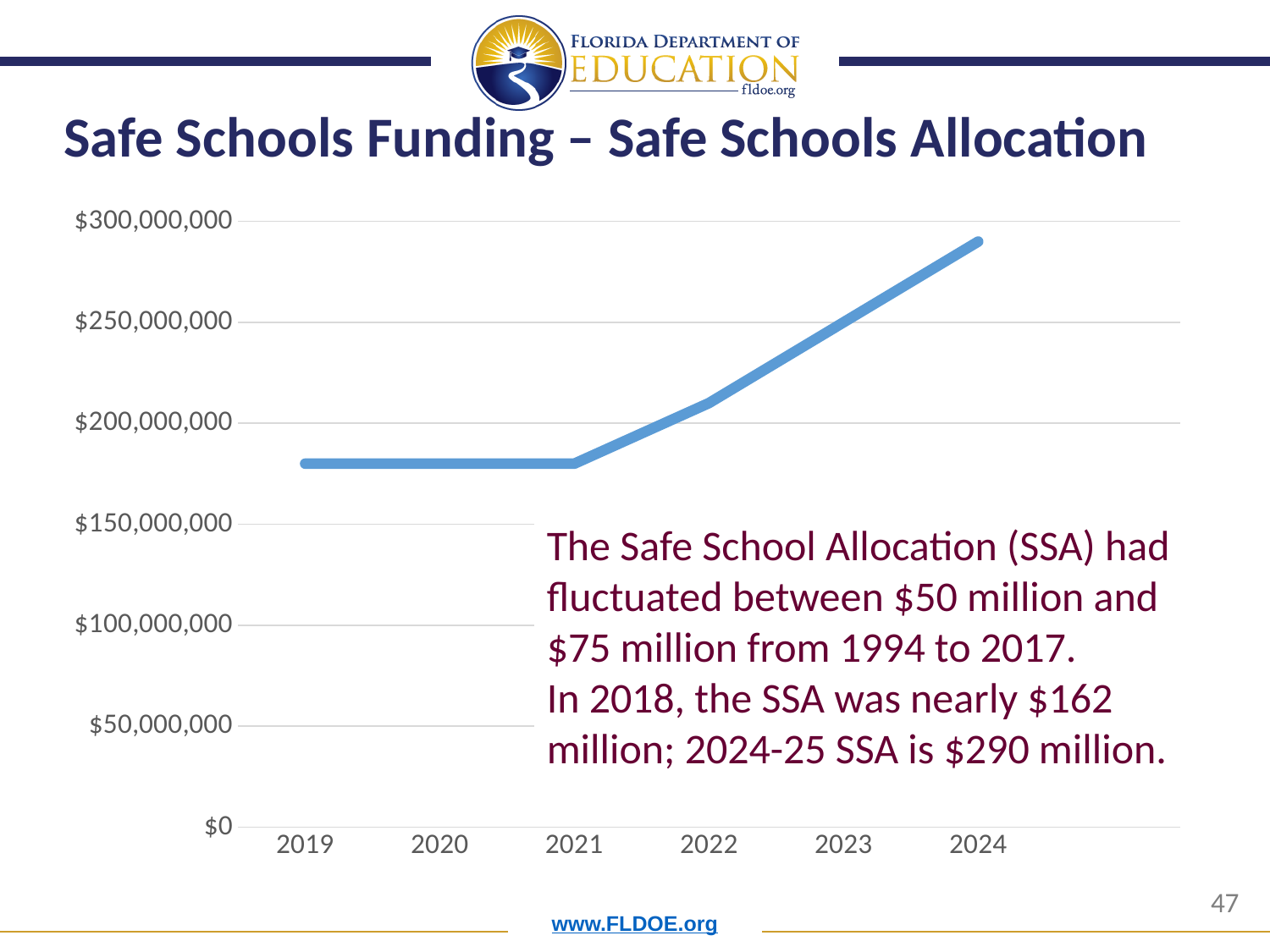
How many years are plotted on the x axis of the chart? 6 Is the value for 2024 greater or less than $250,000,000? greater Is the value for 2021 greater or less than $150,000,000? greater Does the plotted line rise or fall from 2021 to 2024? rise Which is larger, the value for 2023 or the value for 2022? 2023 Is the value for 2020 greater or less than $200,000,000? less Which is larger, the value for 2019 or the value for 2024? 2024 What kind of chart is shown on the slide? line chart Which year has the highest value on the chart? 2024 What is the title of the slide containing the chart? Safe Schools Funding – Safe Schools Allocation